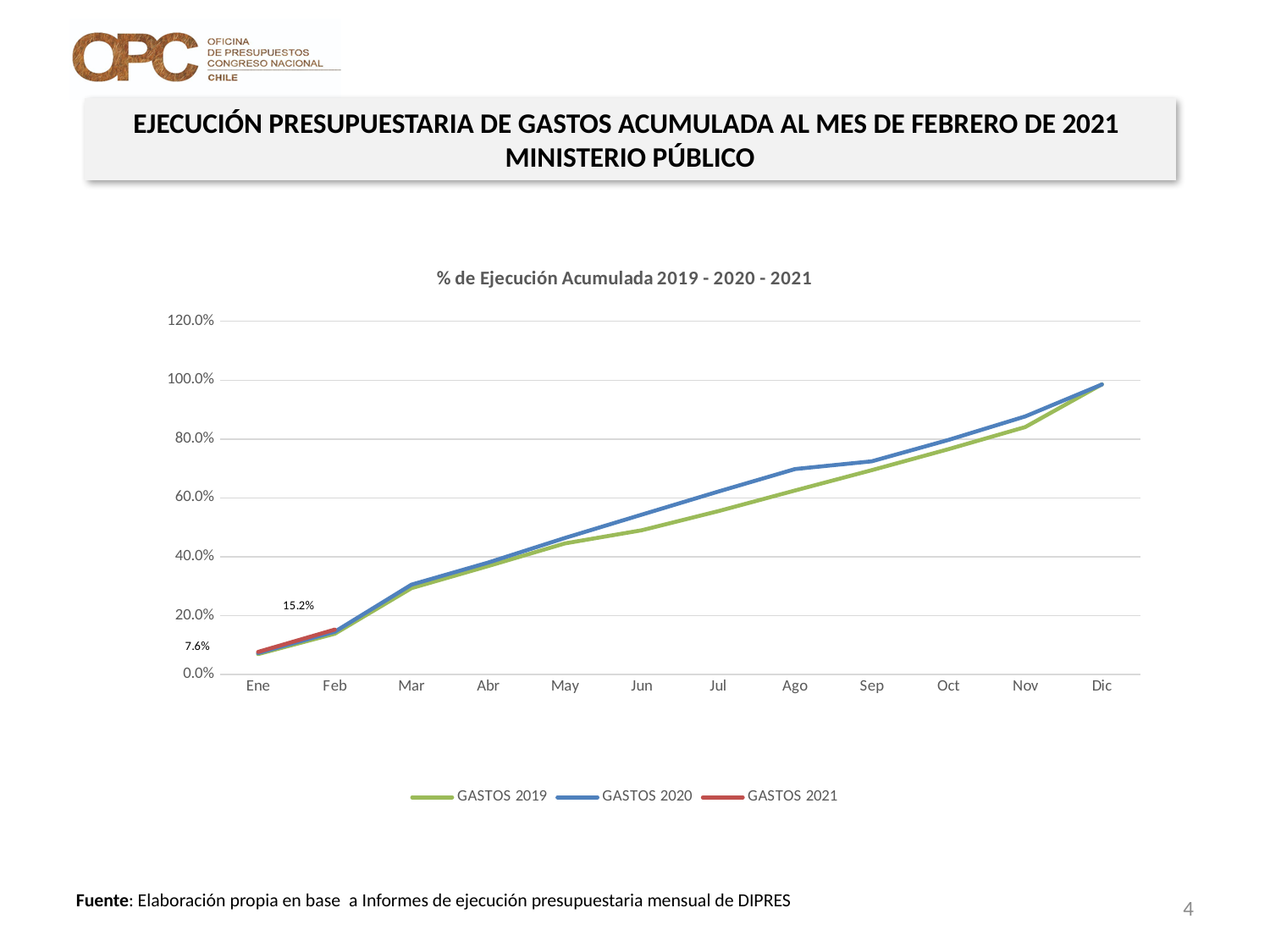
In which month does GASTOS 2020 reach its highest value? Dic Is the value for GASTOS 2019 in Mar greater or less than 40.0%? less In Ago, which series has the larger value, GASTOS 2019 or GASTOS 2020? GASTOS 2020 Is the value for GASTOS 2020 in Ago greater or less than 60.0%? greater How many series does the legend list? 3 What kind of chart is shown on the slide? line chart What is the difference between the GASTOS 2021 values for Feb and Ene? 7.6% What is the title of the chart? % de Ejecución Acumulada 2019 - 2020 - 2021 Do the GASTOS 2020 values rise or fall from Ene to Dic? rise How many months are shown along the x axis? 12 What is the value for GASTOS 2021 in Feb? 15.2% What is the value for GASTOS 2021 in Ene? 7.6%